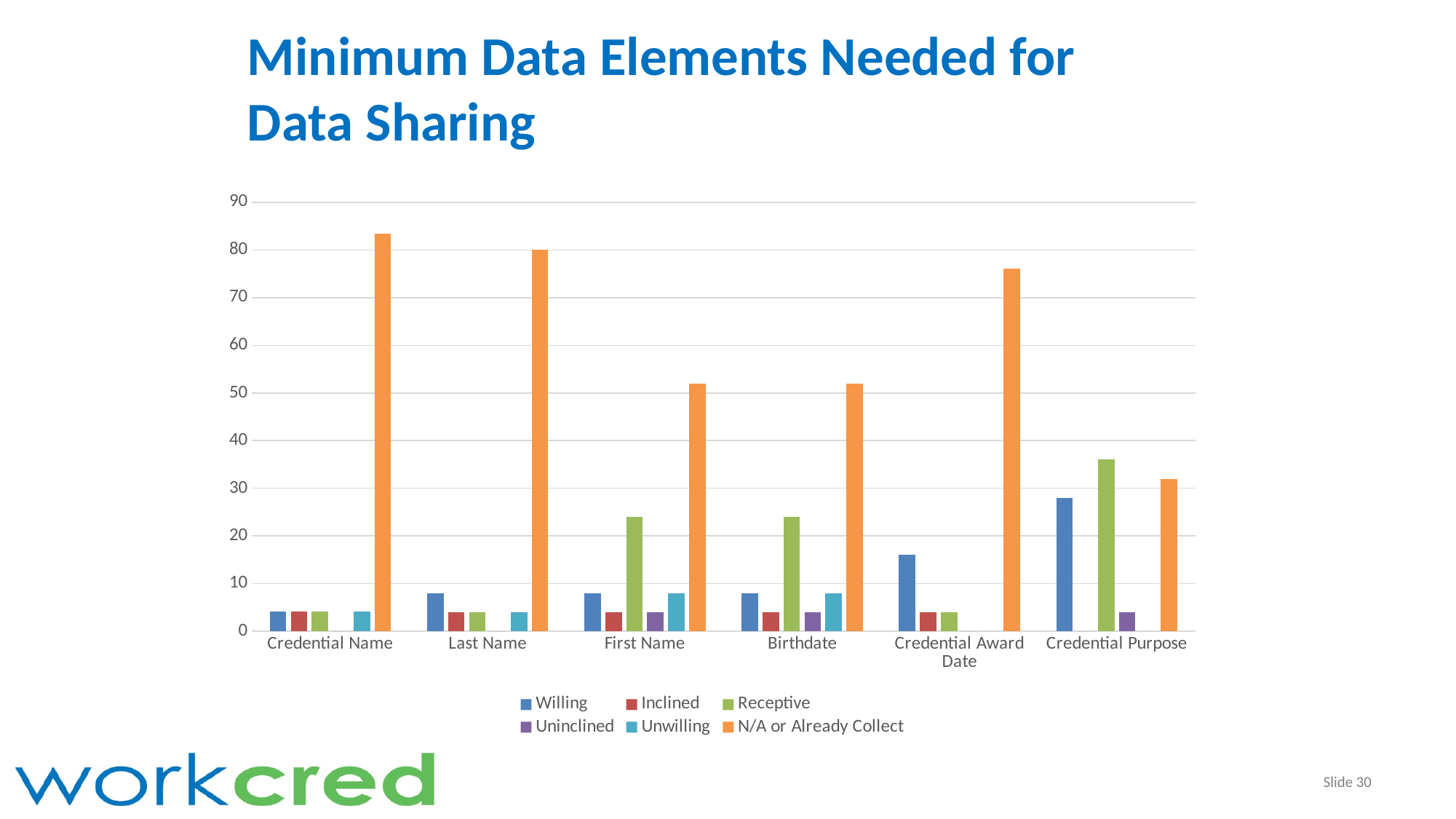
What is the title of the chart on the slide? Minimum Data Elements Needed for Data Sharing Which category has the lowest value for the N/A or Already Collect series? Credential Purpose Which category has the highest value for the Willing series? Credential Purpose How many series does the legend list? 6 Is the N/A or Already Collect value for Birthdate greater or less than 60? less What kind of chart is shown on the slide? bar chart For Credential Purpose, which is larger: the Willing value or the Receptive value? Receptive How many categories are shown on the x axis? 6 Is the N/A or Already Collect value for Credential Name greater or less than 80? greater Is the Receptive value for First Name greater or less than 20? greater Which category has the highest value for the N/A or Already Collect series? Credential Name